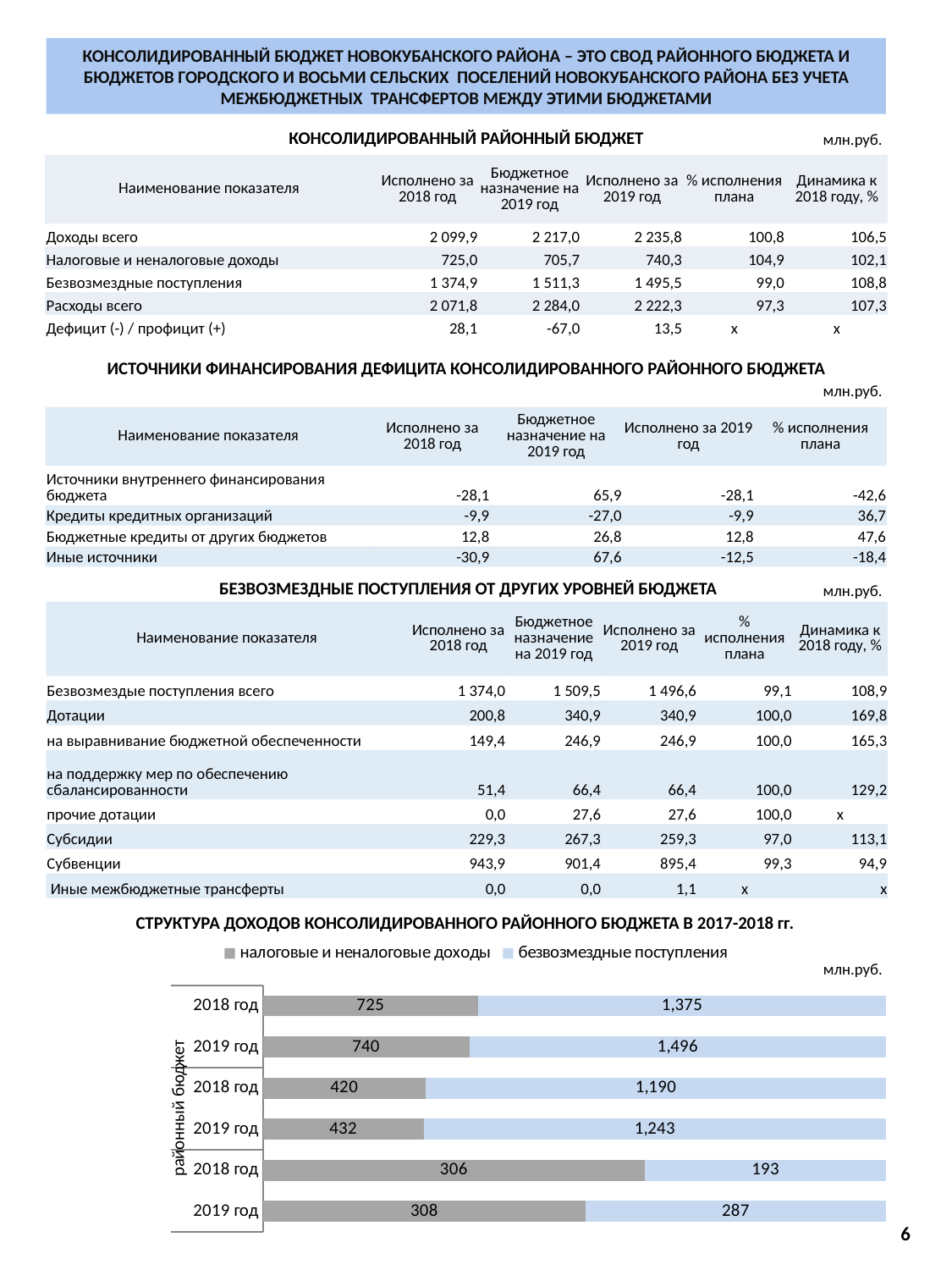
In the bar chart, what is the total of the topmost bar (the first '2018 год')? 2,100 In the bar chart, what is the value of 'безвозмездные поступления' for the second bar from the top (the first '2019 год')? 1,496 What kind of chart is shown at the bottom of the slide under the title 'СТРУКТУРА ДОХОДОВ КОНСОЛИДИРОВАННОГО РАЙОННОГО БЮДЖЕТА В 2017-2018 гг.'? bar chart In the bar chart, what is the value of 'налоговые и неналоговые доходы' for the topmost bar (the first '2018 год')? 725 How many bars are plotted in the bar chart? 6 In the bar chart, which bar has the highest value for 'безвозмездные поступления'? the second bar from the top (the first '2019 год'), 1,496 How many series does the legend of the bar chart list? 2 In the bar chart, what is the difference between 'налоговые и неналоговые доходы' and 'безвозмездные поступления' in the bottom bar (the last '2019 год')? 21 In the bar chart legend, which series is shown in grey? налоговые и неналоговые доходы In the bar chart, what is the value of 'налоговые и неналоговые доходы' for the fourth bar from the top (the second '2019 год')? 432 In the bar chart, what is the total of the bottom bar (the last '2019 год')? 595 In the bar chart, which series is larger in the fifth bar from the top (the last '2018 год'): 'налоговые и неналоговые доходы' or 'безвозмездные поступления'? налоговые и неналоговые доходы